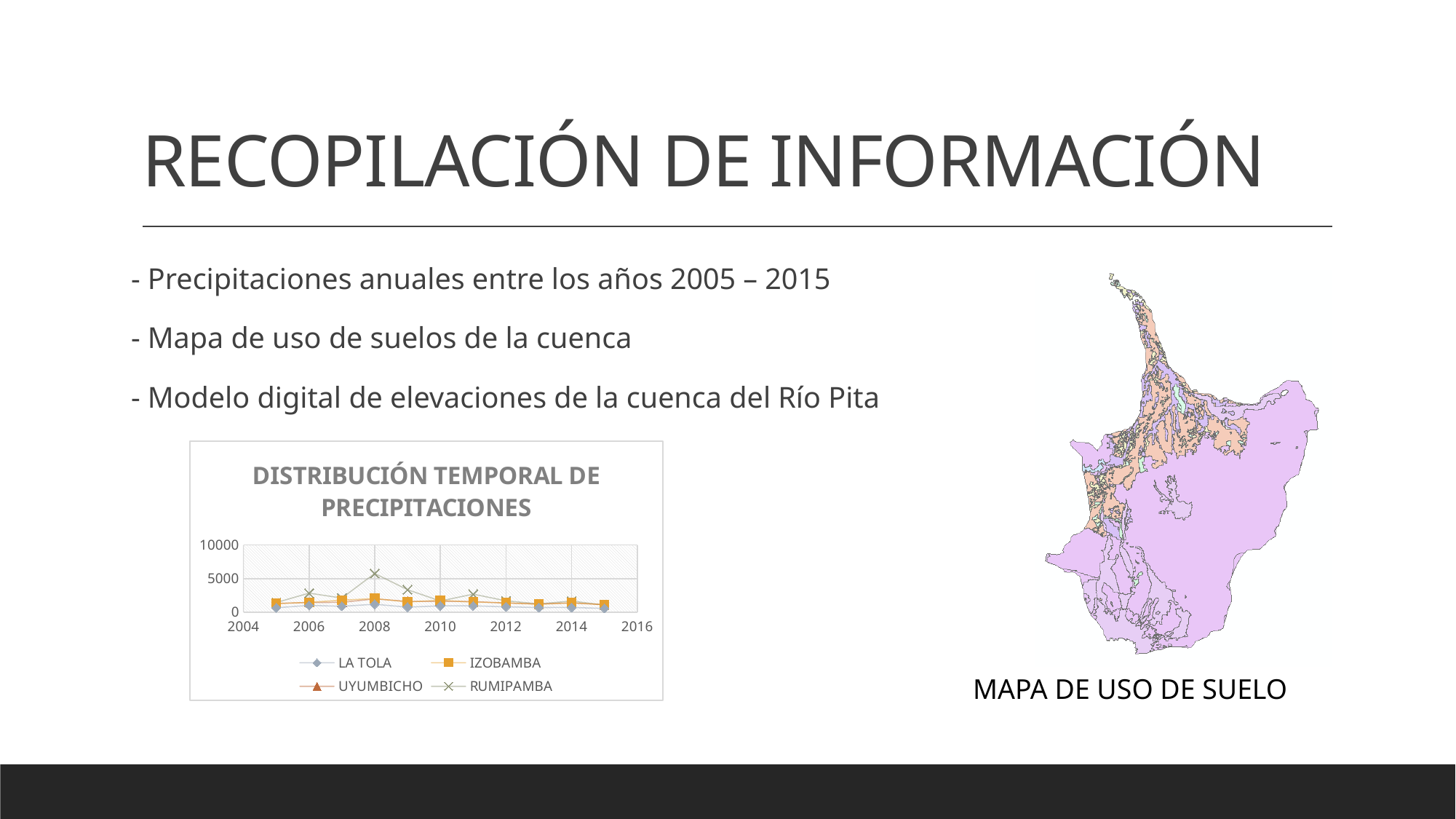
Which is larger in 2008, the value for RUMIPAMBA or the value for LA TOLA? RUMIPAMBA Is the value for IZOBAMBA in 2012 greater or less than 5000? less How many years of data points are plotted for each series in the chart? 11 What is the highest value shown on the chart's vertical axis? 10000 What is the title of the chart on the slide? DISTRIBUCIÓN TEMPORAL DE PRECIPITACIONES Is the value for LA TOLA in 2008 greater or less than 5000? less Does the value for RUMIPAMBA rise or fall from 2008 to 2010? fall Which series are listed in the chart's legend? LA TOLA, IZOBAMBA, UYUMBICHO, RUMIPAMBA What kind of chart is shown on the slide? line chart Which series has the highest value in 2008? RUMIPAMBA How many series does the chart's legend list? 4 Is the value for RUMIPAMBA in 2008 greater or less than 5000? greater